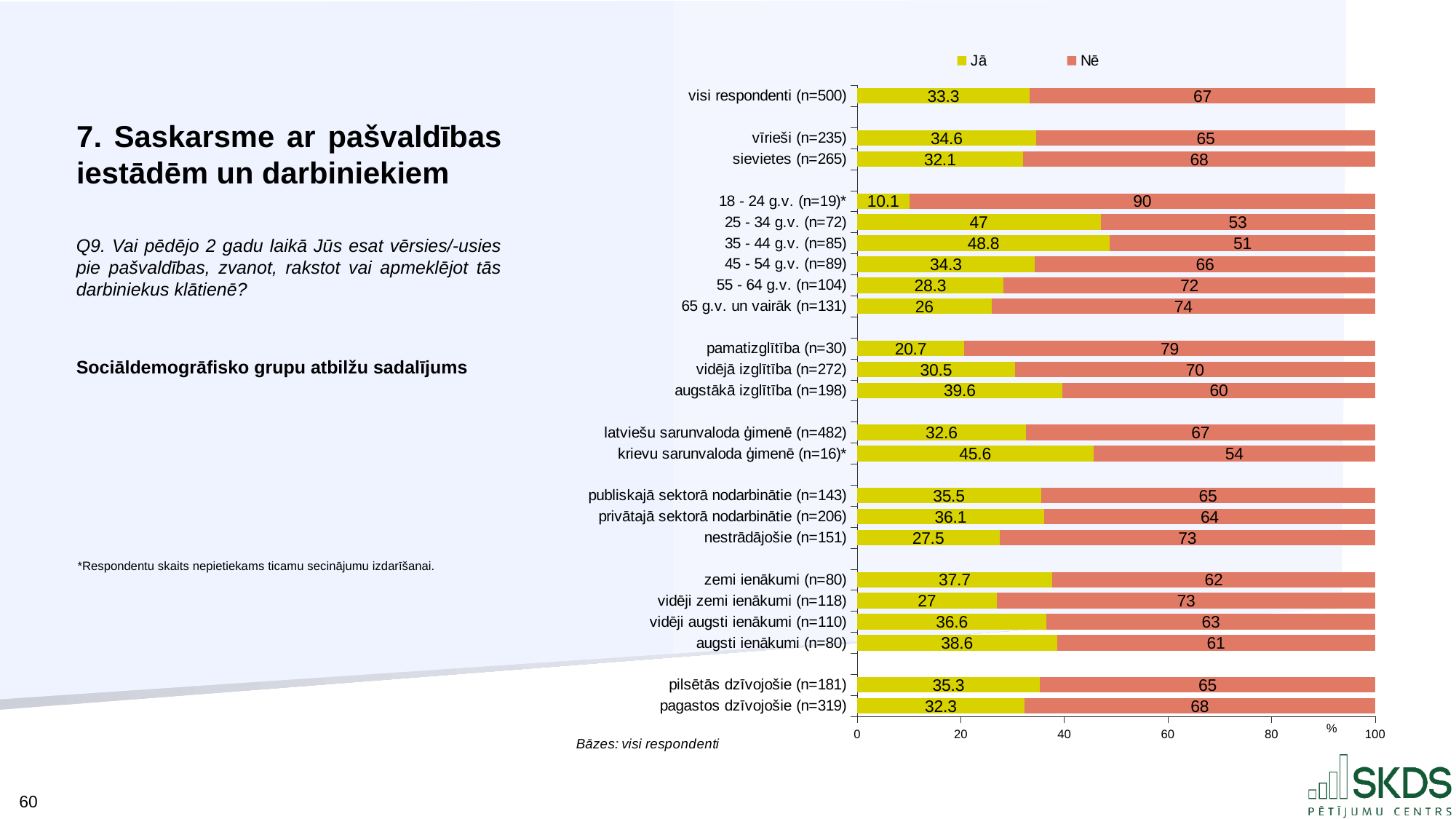
What is the difference between the "Jā" values for "vīrieši (n=235)" and "sievietes (n=265)"? 2.5 What kind of chart is shown on the slide? Stacked bar chart What is the "Jā" value for "visi respondenti (n=500)"? 33.3 How many series does the legend list? 2 What is the "Jā" value for "augstākā izglītība (n=198)"? 39.6 What are the two legend entries of the chart? Jā and Nē Is the "Jā" value for "25 - 34 g.v. (n=72)" greater or less than 40? greater What is the "Nē" value for "nestrādājošie (n=151)"? 73 What is the "Nē" value for "18 - 24 g.v. (n=19)*"? 90 Which has a larger "Jā" value: "pilsētās dzīvojošie (n=181)" or "pagastos dzīvojošie (n=319)"? pilsētās dzīvojošie (n=181) Which category has the highest "Jā" value? 35 - 44 g.v. (n=85) Which category has the lowest "Jā" value? 18 - 24 g.v. (n=19)*